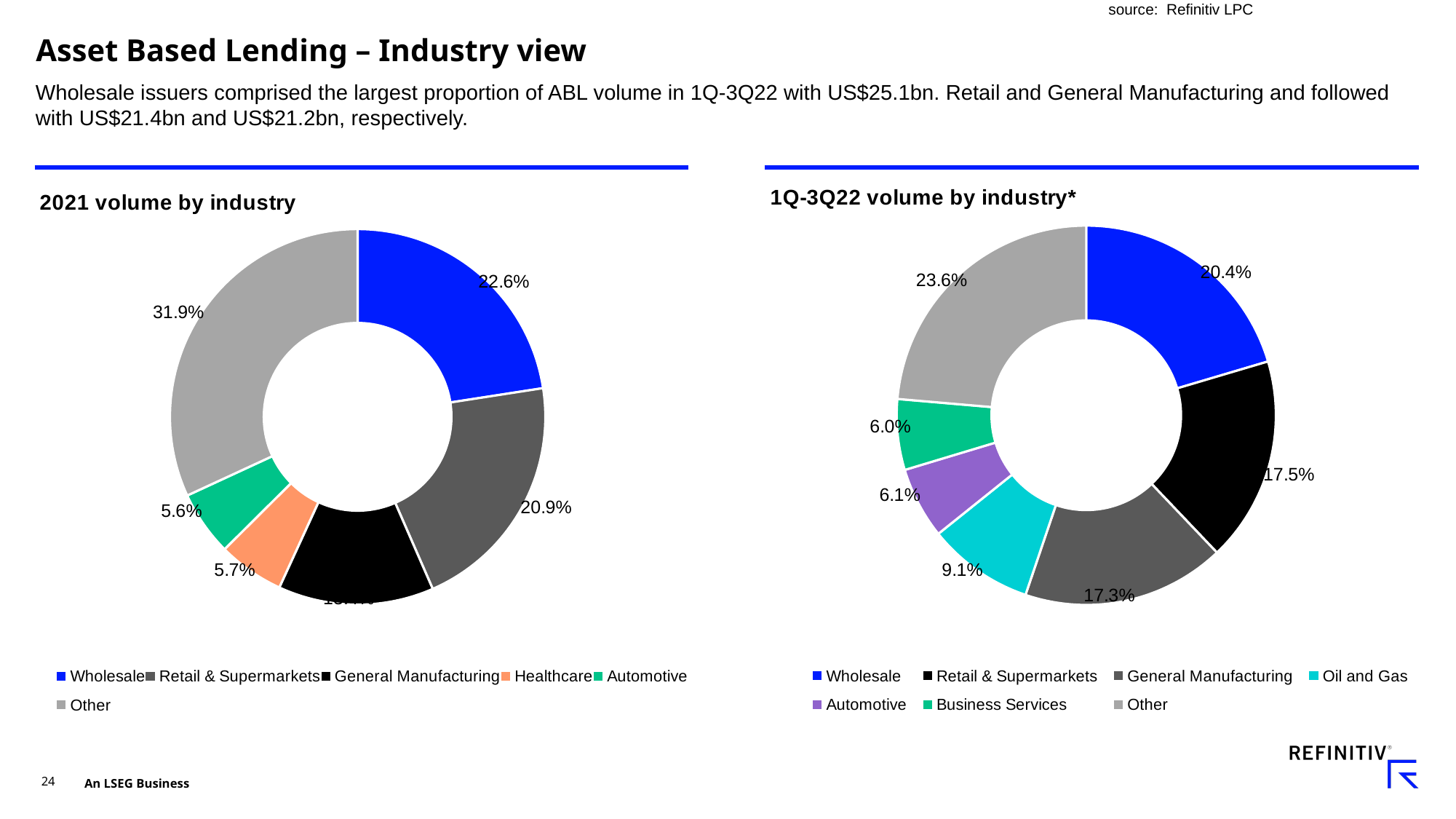
In the '1Q-3Q22 volume by industry*' chart, what share does Oil and Gas have? 9.1% In the '2021 volume by industry' chart, what share does Retail & Supermarkets have? 20.9% In the '2021 volume by industry' chart, what share does Wholesale have? 22.6% In the '1Q-3Q22 volume by industry*' chart, what share does Other have? 23.6% In the '2021 volume by industry' chart, what share does Other have? 31.9% In the '1Q-3Q22 volume by industry*' chart, which is larger, Wholesale or Oil and Gas? Wholesale In the '2021 volume by industry' chart, which category has the largest share? Other In the '1Q-3Q22 volume by industry*' chart, what is the difference between the Other and Wholesale shares? 3.2% In the '1Q-3Q22 volume by industry*' chart, what share does Wholesale have? 20.4% What type of chart is the '2021 volume by industry' chart? Donut (pie) chart How many categories does the legend of the '1Q-3Q22 volume by industry*' chart list? 7 In the '2021 volume by industry' chart, what is the difference between the Wholesale and Retail & Supermarkets shares? 1.7%